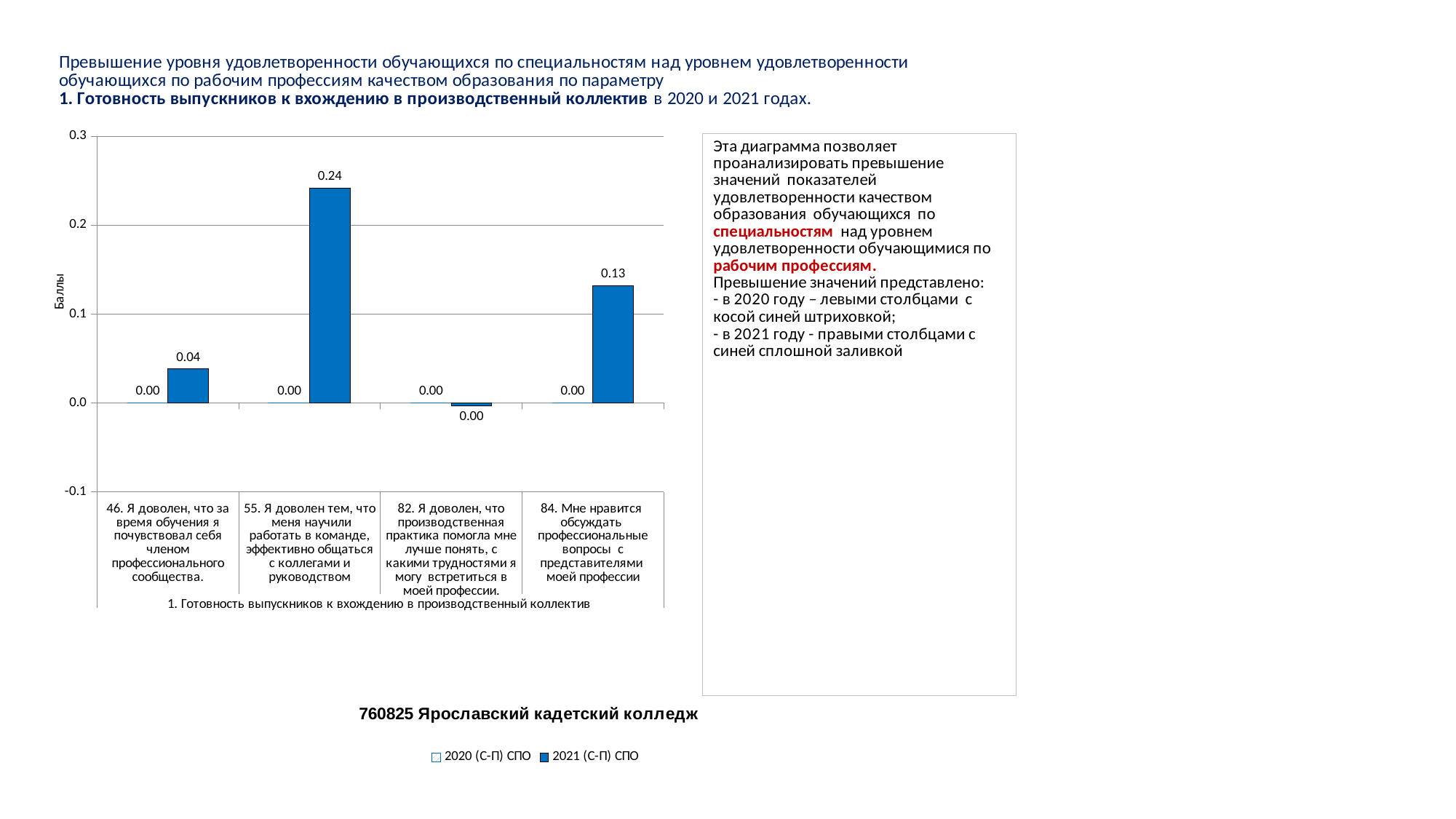
What is the label of the vertical axis of the chart? Баллы What is the value of the 2020 (С-П) СПО series for statement 82 ("Я доволен, что производственная практика помогла мне лучше понять...")? 0.00 Is the 2021 (С-П) СПО value for statement 55 greater or less than 0.2? greater What is the value of the 2021 (С-П) СПО series for statement 46 ("Я доволен, что за время обучения я почувствовал себя членом профессионального сообщества")? 0.04 Which statement has the highest 2021 (С-П) СПО value? 55. Я доволен тем, что меня научили работать в команде, эффективно общаться с коллегами и руководством How many statements (categories) are shown on the x axis of the chart? 4 What is the difference between the 2021 (С-П) СПО values for statement 55 and statement 84? 0.11 What type of chart is shown on the slide? Bar chart What is the value of the 2021 (С-П) СПО series for statement 84 ("Мне нравится обсуждать профессиональные вопросы с представителями моей профессии")? 0.13 Which is larger for the 2021 (С-П) СПО series: the value for statement 46 or the value for statement 84? Statement 84 What is the value of the 2021 (С-П) СПО series for statement 55 ("Я доволен тем, что меня научили работать в команде...")? 0.24 How many series does the chart legend list? 2